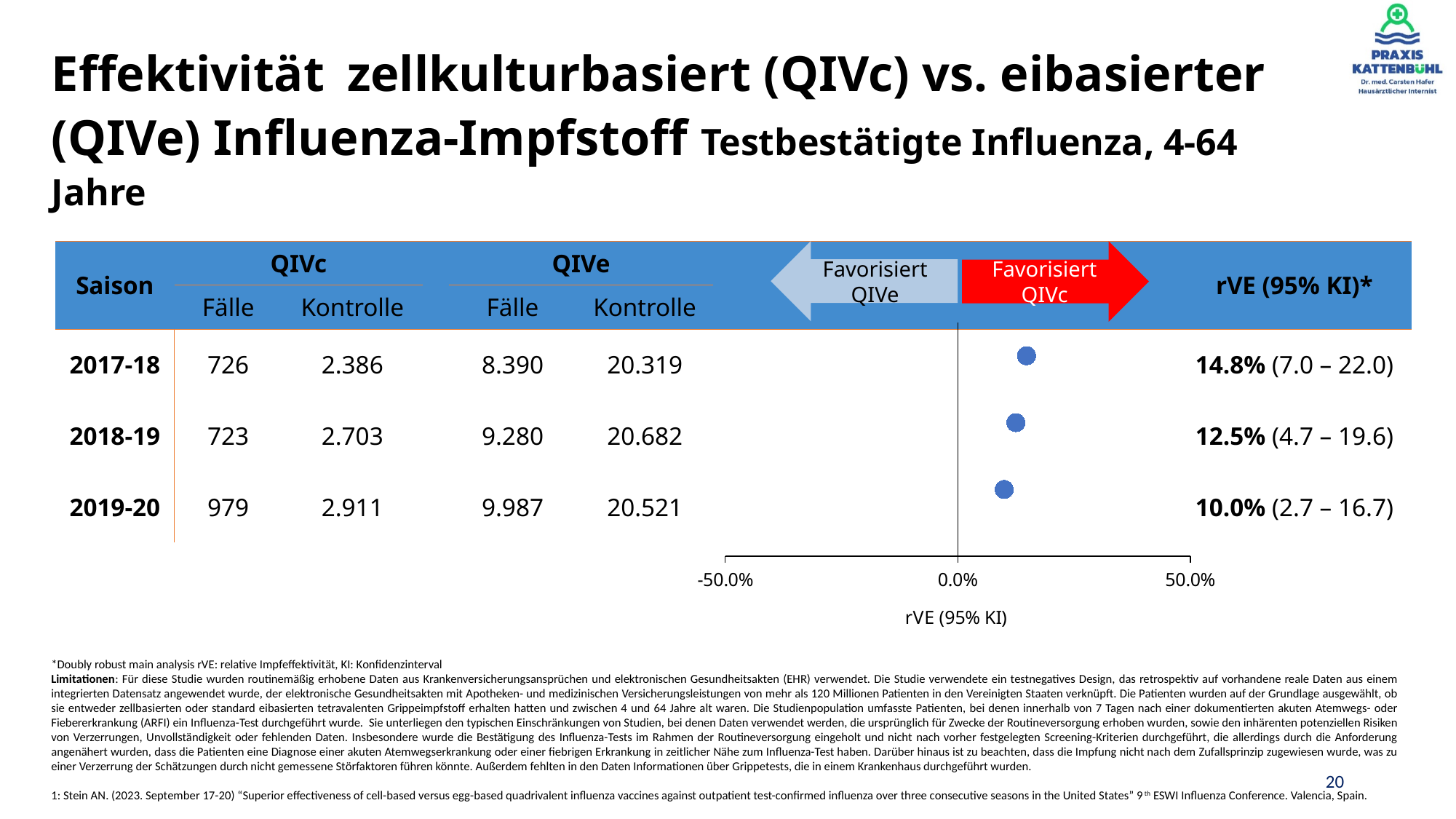
Which season has the highest plotted rVE? 2017-18 How many seasons (data points) are plotted in the rVE chart? 3 Which is larger, the rVE for 2018-19 or the rVE for 2019-20? 2018-19 What is the rVE value plotted for the 2019-20 season? 10.0% Do the plotted rVE values rise or fall from the 2017-18 season to the 2019-20 season? fall What is the difference between the rVE for 2017-18 and the rVE for 2019-20? 4.8% What is the 95% confidence interval shown for the 2018-19 rVE? 4.7 – 19.6 What is the label of the horizontal axis of the chart? rVE (95% KI) Which season has the lowest plotted rVE? 2019-20 Is the plotted rVE for 2017-18 greater or less than 0.0%? greater What is the rVE value plotted for the 2017-18 season? 14.8% What is the rVE value plotted for the 2018-19 season? 12.5%